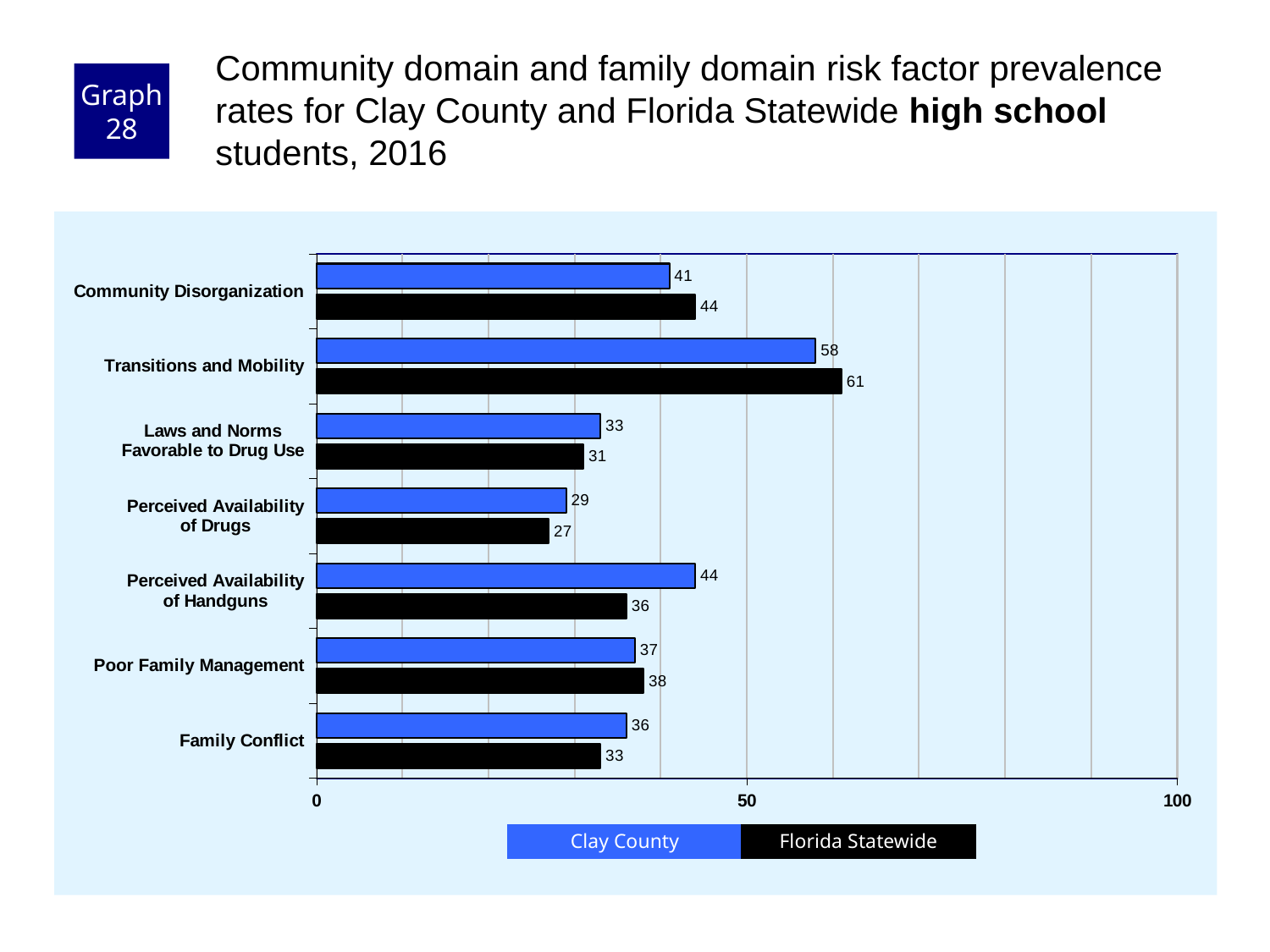
What is the Clay County value for Perceived Availability of Handguns? 44 How many risk factor categories are shown on the chart? 7 What is the Clay County value for Transitions and Mobility? 58 Which colour represents Florida Statewide in the chart? black Is the Florida Statewide value for Transitions and Mobility greater or less than 50? greater What is the difference between the Florida Statewide and Clay County values for Community Disorganization? 3 What is the Florida Statewide value for Perceived Availability of Drugs? 27 Which risk factor has the highest Florida Statewide value? Transitions and Mobility For Perceived Availability of Handguns, which is larger: the Clay County value or the Florida Statewide value? Clay County How many series does the legend list? 2 What kind of chart is shown on the slide? bar chart Which risk factor has the lowest Clay County value? Perceived Availability of Drugs